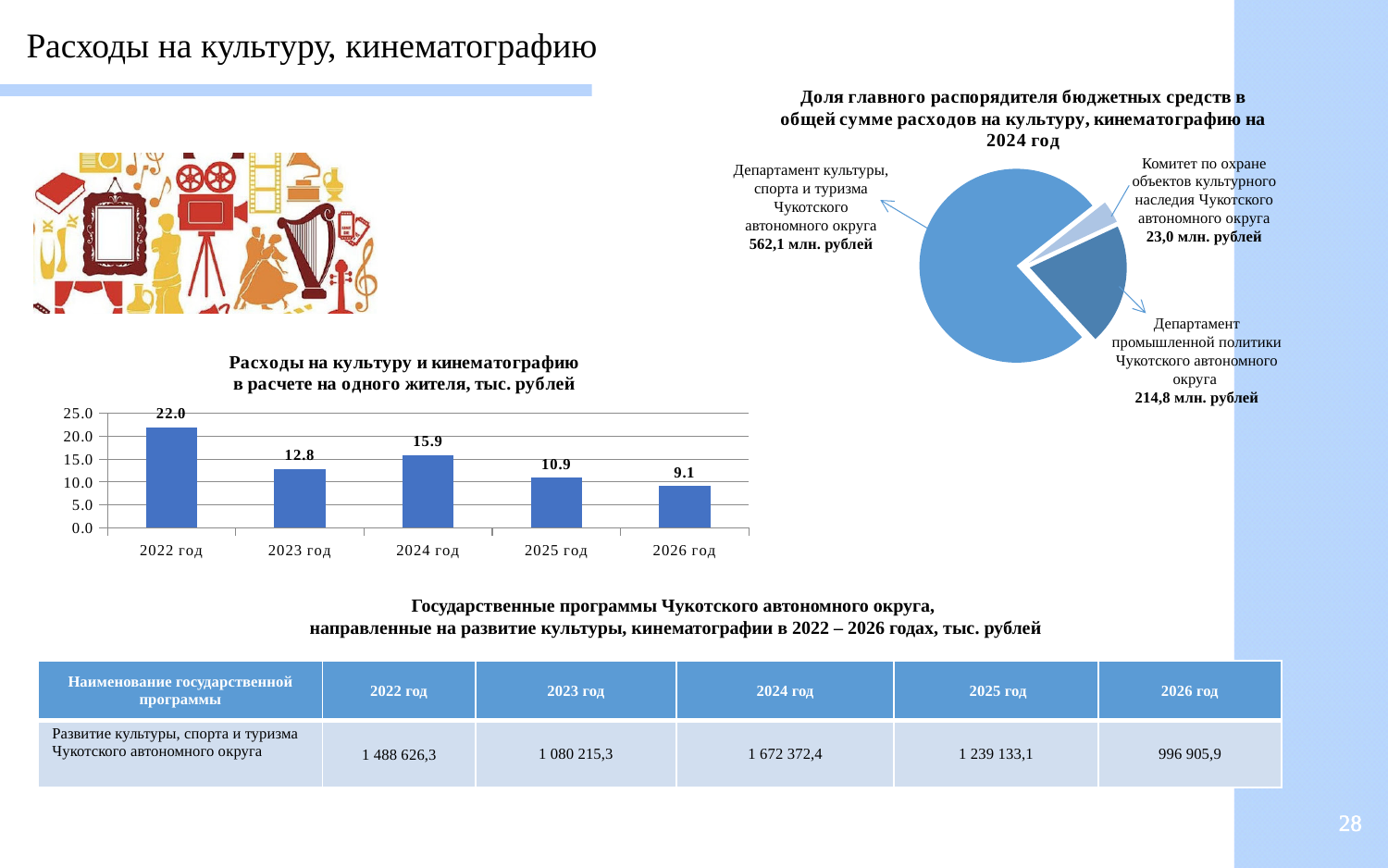
What kind of chart is 'Расходы на культуру и кинематографию в расчете на одного жителя, тыс. рублей'? Bar chart What kind of chart is 'Доля главного распорядителя бюджетных средств в общей сумме расходов на культуру, кинематографию на 2024 год'? Pie chart On the bar chart 'Расходы на культуру и кинематографию в расчете на одного жителя, тыс. рублей', what is the value for 2025 год? 10.9 On the bar chart 'Расходы на культуру и кинематографию в расчете на одного жителя, тыс. рублей', which is larger: the value for 2024 год or 2025 год? 2024 год On the bar chart 'Расходы на культуру и кинематографию в расчете на одного жителя, тыс. рублей', what is the value for 2022 год? 22.0 On the bar chart 'Расходы на культуру и кинематографию в расчете на одного жителя, тыс. рублей', what is the difference between the values for 2022 год and 2023 год? 9.2 On the pie chart 'Доля главного распорядителя бюджетных средств в общей сумме расходов на культуру, кинематографию на 2024 год', which entity has the smallest slice? Комитет по охране объектов культурного наследия Чукотского автономного округа On the pie chart 'Доля главного распорядителя бюджетных средств в общей сумме расходов на культуру, кинематографию на 2024 год', what is the value for Комитет по охране объектов культурного наследия Чукотского автономного округа? 23,0 млн. рублей On the bar chart 'Расходы на культуру и кинематографию в расчете на одного жителя, тыс. рублей', which year has the highest value? 2022 год On the bar chart 'Расходы на культуру и кинематографию в расчете на одного жителя, тыс. рублей', how many years are shown? 5 On the bar chart 'Расходы на культуру и кинематографию в расчете на одного жителя, тыс. рублей', which year has the lowest value? 2026 год On the pie chart 'Доля главного распорядителя бюджетных средств в общей сумме расходов на культуру, кинематографию на 2024 год', what is the value for Департамент культуры, спорта и туризма Чукотского автономного округа? 562,1 млн. рублей